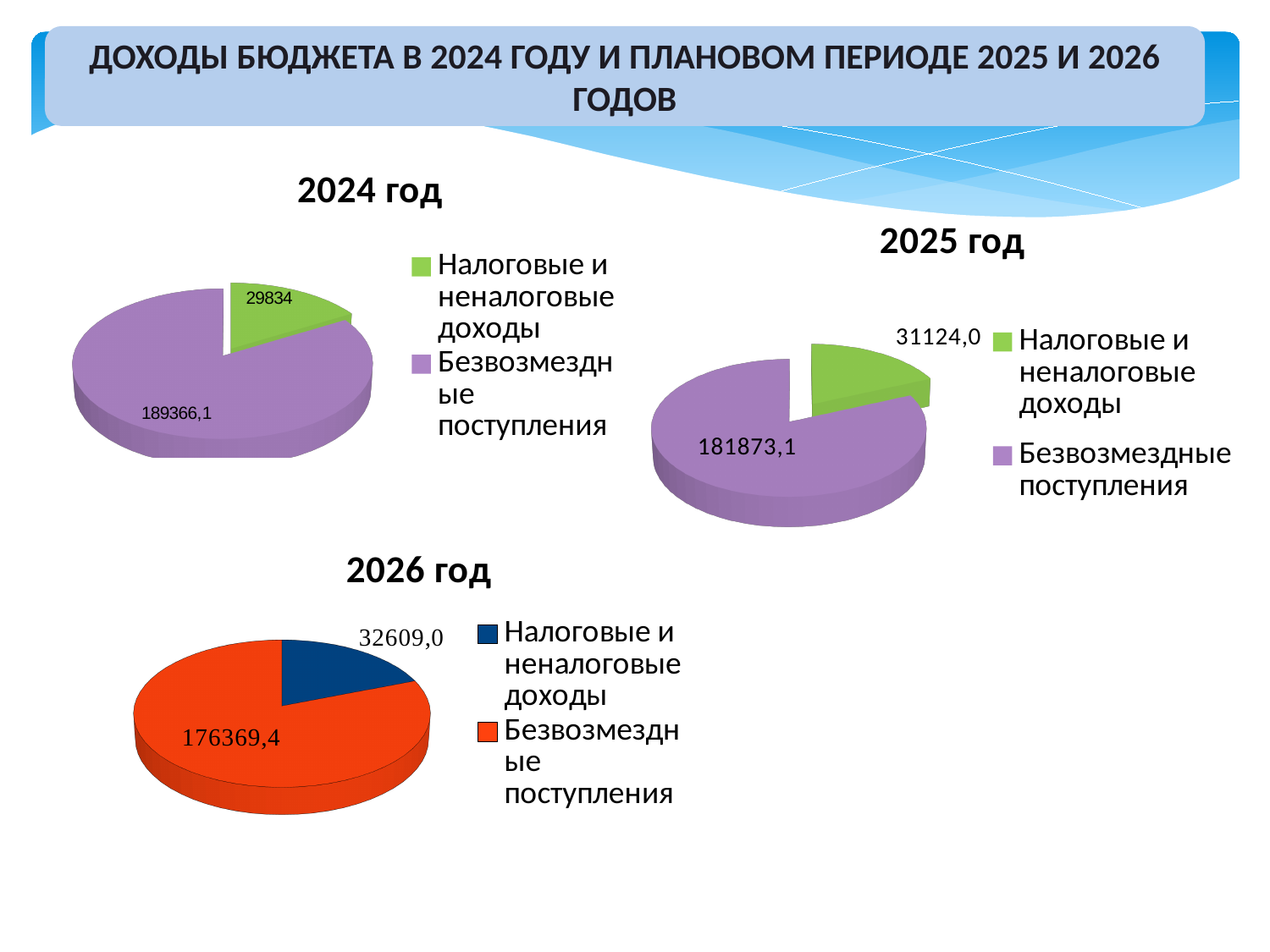
In the 2024 год chart, what is the value for Налоговые и неналоговые доходы? 29834 In the 2026 год chart, what is the value for Безвозмездные поступления? 176369,4 In the 2026 год chart, what is the value for Налоговые и неналоговые доходы? 32609,0 In the 2025 год chart, what is the value for Налоговые и неналоговые доходы? 31124,0 In the 2024 год chart, which category has the largest slice? Безвозмездные поступления In the 2026 год chart, which category has the smallest slice? Налоговые и неналоговые доходы In the 2025 год chart, what is the difference between Безвозмездные поступления and Налоговые и неналоговые доходы? 150749,1 In the 2024 год chart, what is the total of the two slices? 219200,1 In the 2025 год chart, what is the value for Безвозмездные поступления? 181873,1 In the 2024 год chart, what is the value for Безвозмездные поступления? 189366,1 How many slices does the 2025 год chart have? 2 What kind of chart is the 2026 год chart? Pie chart